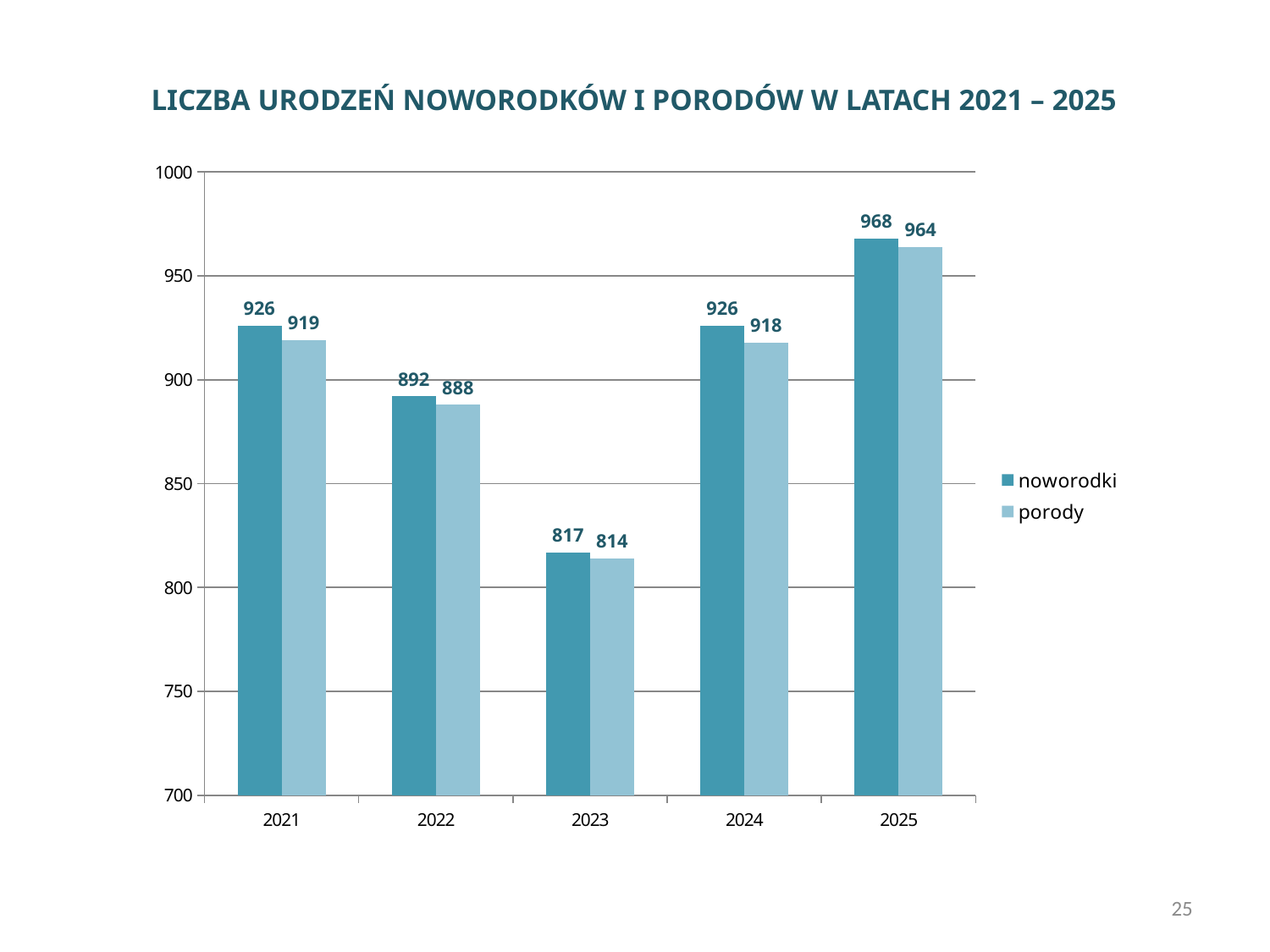
Which year has the highest value for noworodki? 2025 Which is larger, the porody value in 2024 or in 2021? 2021 Which year has the lowest value for porody? 2023 What is the value for porody in 2021? 919 How many years are shown on the x axis? 5 How many series does the legend list? 2 What is the value for porody in 2025? 964 What is the difference between the noworodki value in 2025 and in 2023? 151 What is the value for noworodki in 2023? 817 What kind of chart is shown on the slide? bar chart What is the difference between noworodki and porody in 2022? 4 Is the value for noworodki in 2022 greater or less than 900? less